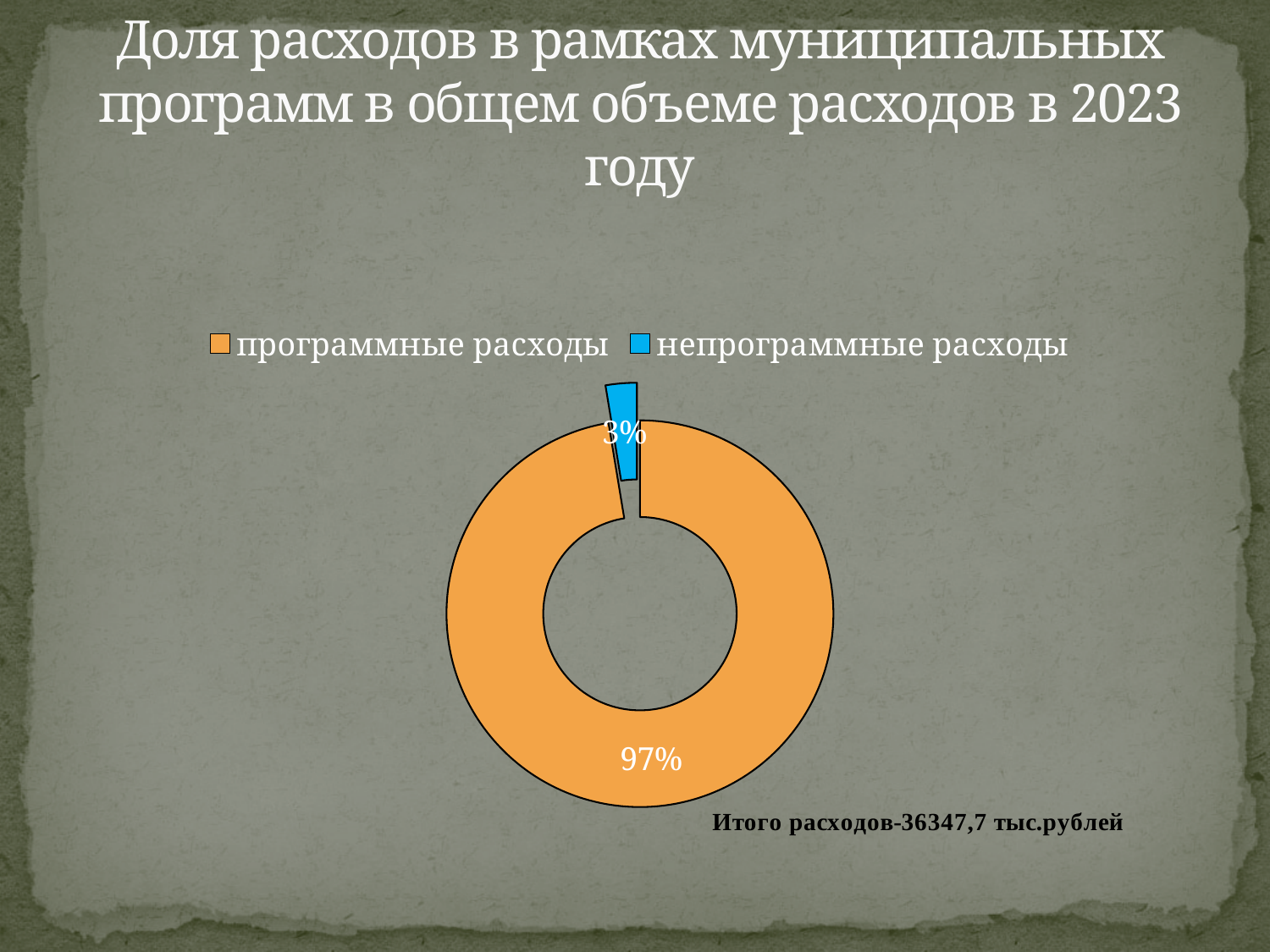
What share of the chart does 'непрограммные расходы' represent? 3% What total expenditure is stated in the note below the chart? 36347,7 тыс.рублей What share of the chart does 'программные расходы' represent? 97% Which category has the smallest share? непрограммные расходы Which category has the largest share? программные расходы How many categories does the chart show? 2 How many entries does the legend list? 2 Which is larger: 'программные расходы' or 'непрограммные расходы'? программные расходы What is the difference in percentage points between 'программные расходы' and 'непрограммные расходы'? 94 What colour is the slice for 'непрограммные расходы'? blue What kind of chart is shown on the slide? doughnut (pie) chart